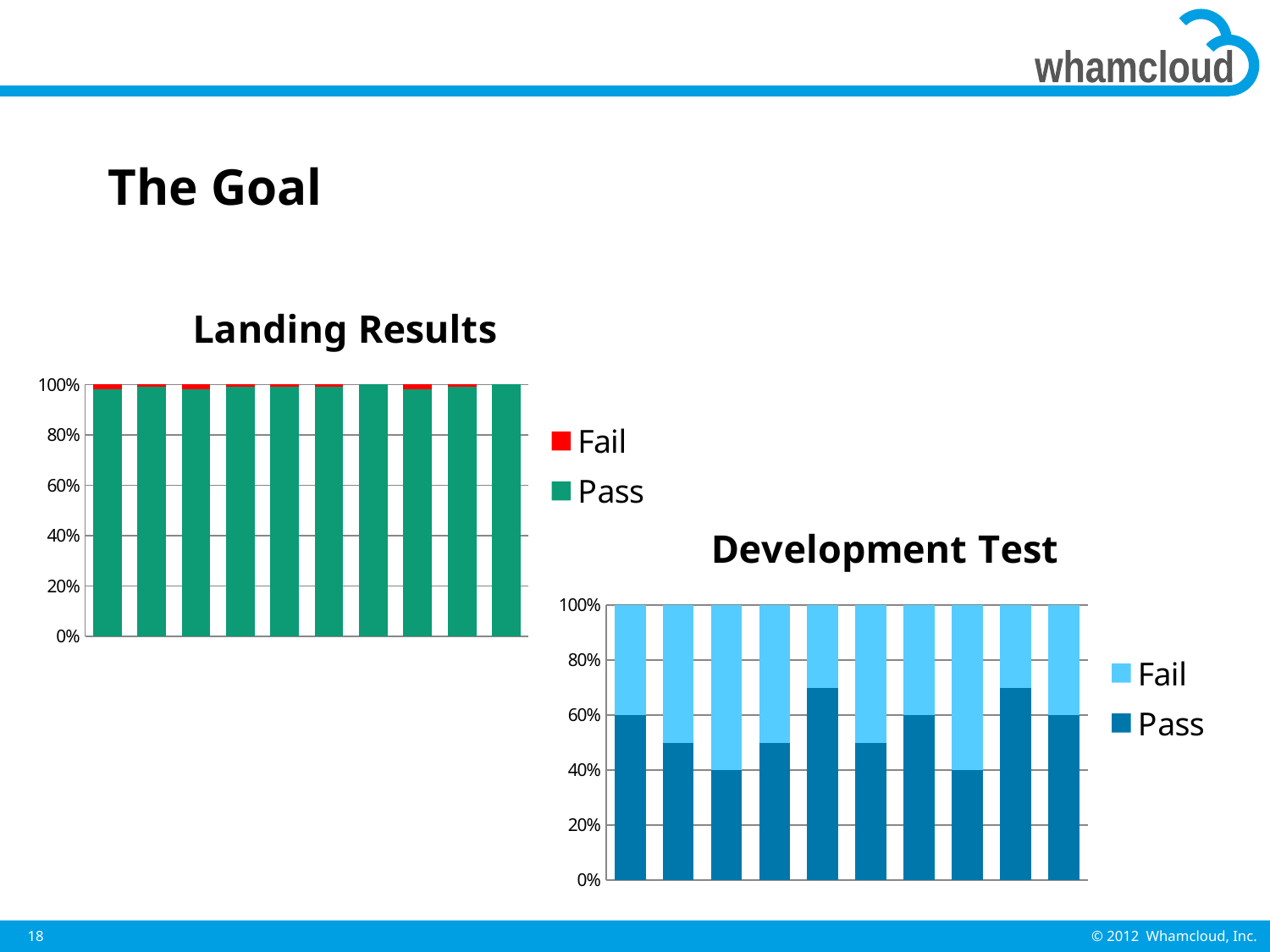
How many series does the legend of the Development Test chart list? 2 In the Development Test chart, is the Pass value for the fifth bar from the left greater or less than 60%? greater How many bars are plotted in the Landing Results chart? 10 In the Development Test chart, is the Pass value for the first bar from the left greater or less than 50%? greater How many bars are plotted in the Development Test chart? 10 What kind of chart is the Development Test chart? stacked bar chart In the Development Test chart, which is larger, the Pass value for the fifth bar from the left or the Pass value for the third bar from the left? the fifth bar What are the two legend entries in the Landing Results chart? Fail and Pass What colour represents Fail in the Landing Results chart? red In the Development Test chart, is the Pass value for the third bar from the left greater or less than 50%? less What kind of chart is the Landing Results chart? stacked bar chart